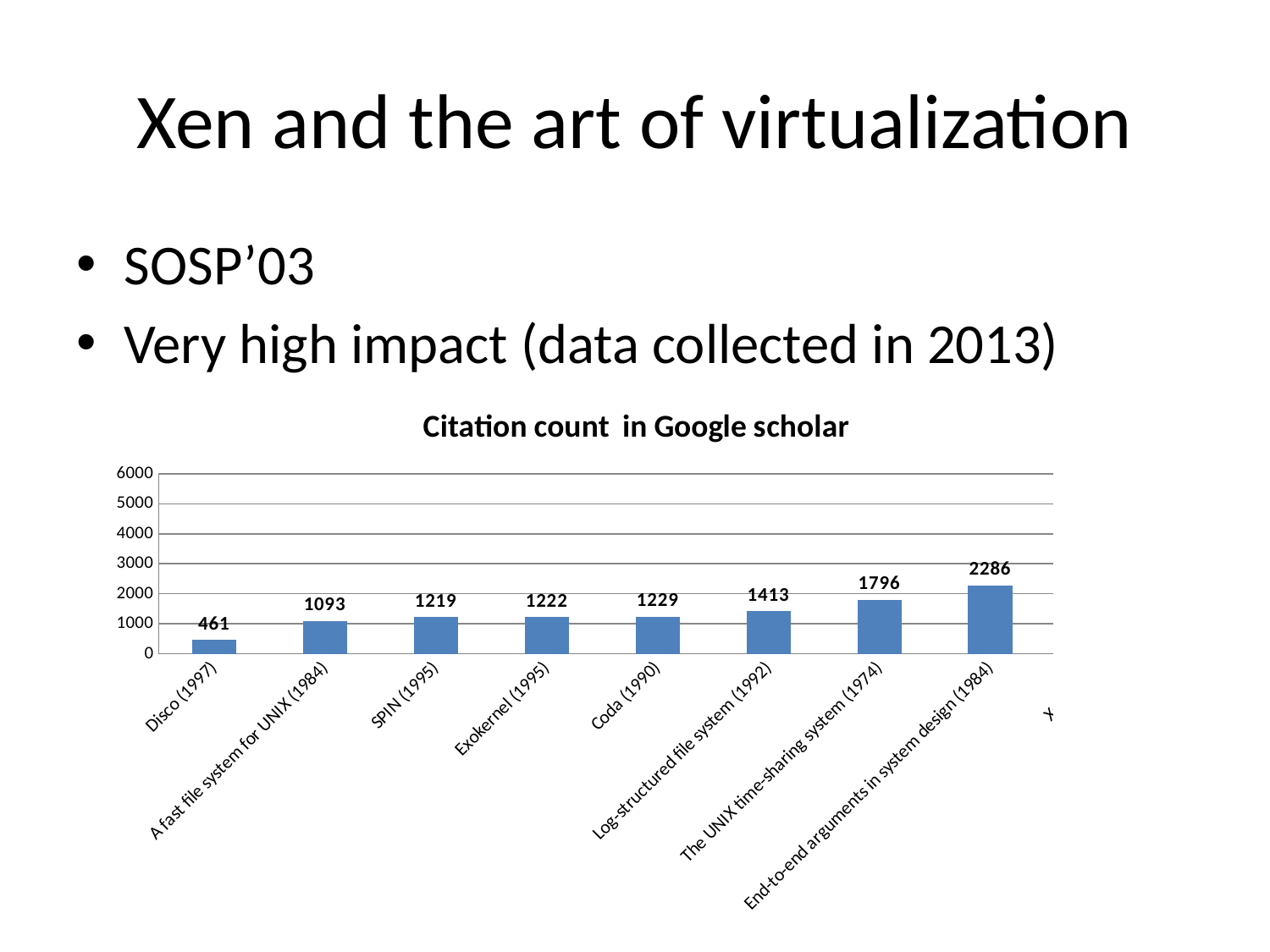
Which has a higher citation count, A fast file system for UNIX (1984) or Coda (1990)? Coda (1990) What is the citation count shown for Disco (1997)? 461 Is the citation count for SPIN (1995) greater or less than 1000? greater What is the citation count shown for Log-structured file system (1992)? 1413 What is the difference in citation count between End-to-end arguments in system design (1984) and Disco (1997)? 1825 Which of the labelled bars has the lowest citation count? Disco (1997) Which of the labelled bars has the highest citation count? End-to-end arguments in system design (1984) What is the citation count shown for End-to-end arguments in system design (1984)? 2286 What kind of chart is shown on the slide? Bar chart What is the title of the chart? Citation count in Google scholar What is the difference in citation count between The UNIX time-sharing system (1974) and Log-structured file system (1992)? 383 What is the citation count shown for The UNIX time-sharing system (1974)? 1796